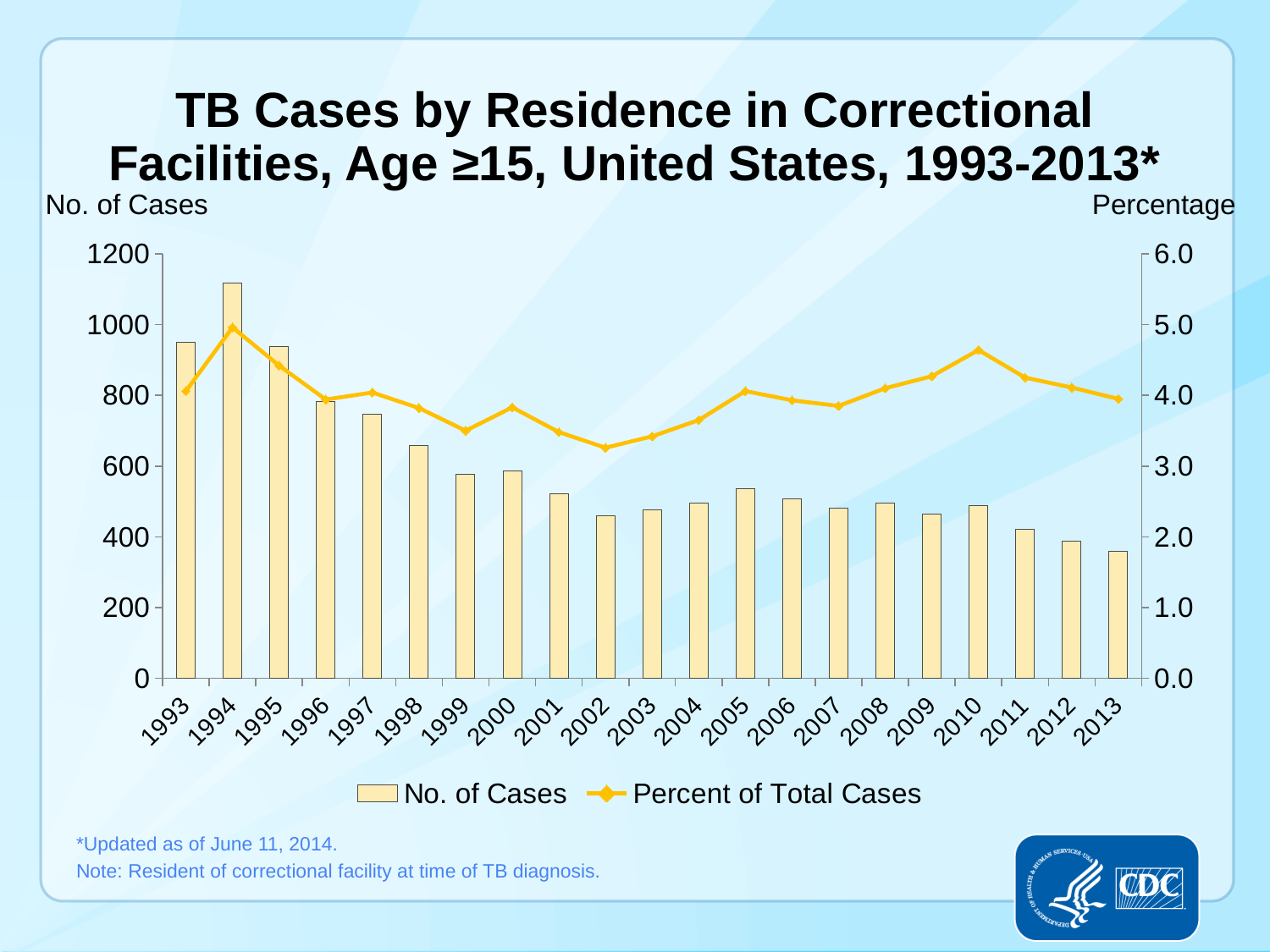
What kind of chart is shown on the slide? Combined bar and line chart Overall, does the number of cases rise or fall from 1993 to 2013? fall Is the number of cases in 1994 greater or less than 1000? greater What is the label of the right-hand vertical axis? Percentage Which year has the highest number of cases? 1994 In which year does the Percent of Total Cases line reach its highest point? 1994 How many series does the legend list? 2 How many years are shown on the x axis? 21 In which year does the Percent of Total Cases line reach its lowest point? 2002 Is the number of cases in 2013 greater or less than 400? less Which year has more cases, 1993 or 2005? 1993 Which year has the lowest number of cases? 2013